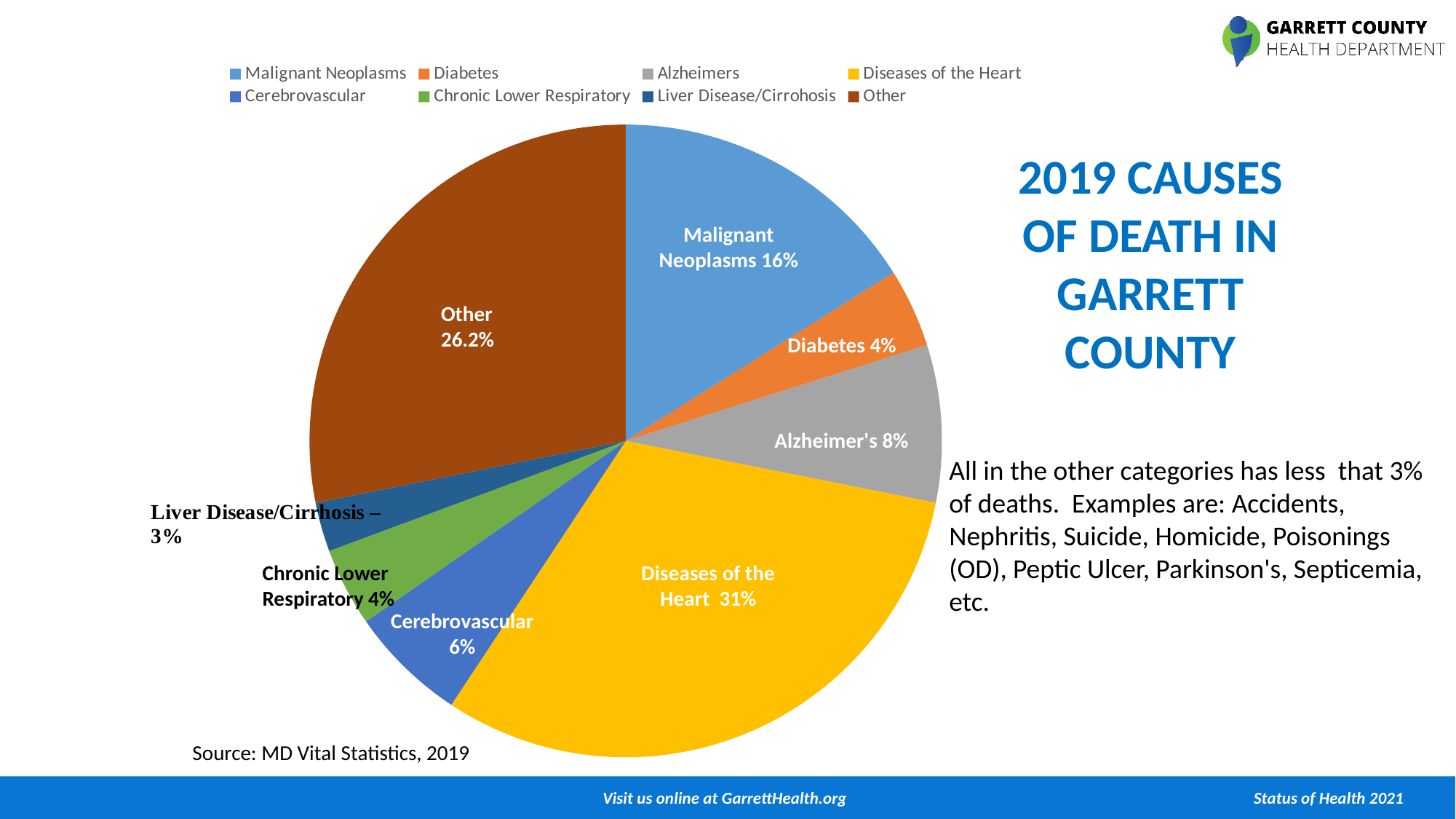
What is the difference in percentage points between Diseases of the Heart and Malignant Neoplasms? 15 Which named cause of death (excluding Other) has the largest share? Diseases of the Heart Which is larger, the share for Alzheimer's or the share for Cerebrovascular? Alzheimer's What share of deaths falls in the Other category? 26.2% What share of deaths is attributed to Malignant Neoplasms? 16% What share of deaths is attributed to Cerebrovascular causes? 6% What share of deaths is attributed to Diseases of the Heart? 31% What colour is the Diseases of the Heart slice? yellow How many categories does the legend list? 8 Which cause of death has the smallest share? Liver Disease/Cirrhosis What kind of chart is shown on the slide? pie chart What share of deaths is attributed to Alzheimer's? 8%